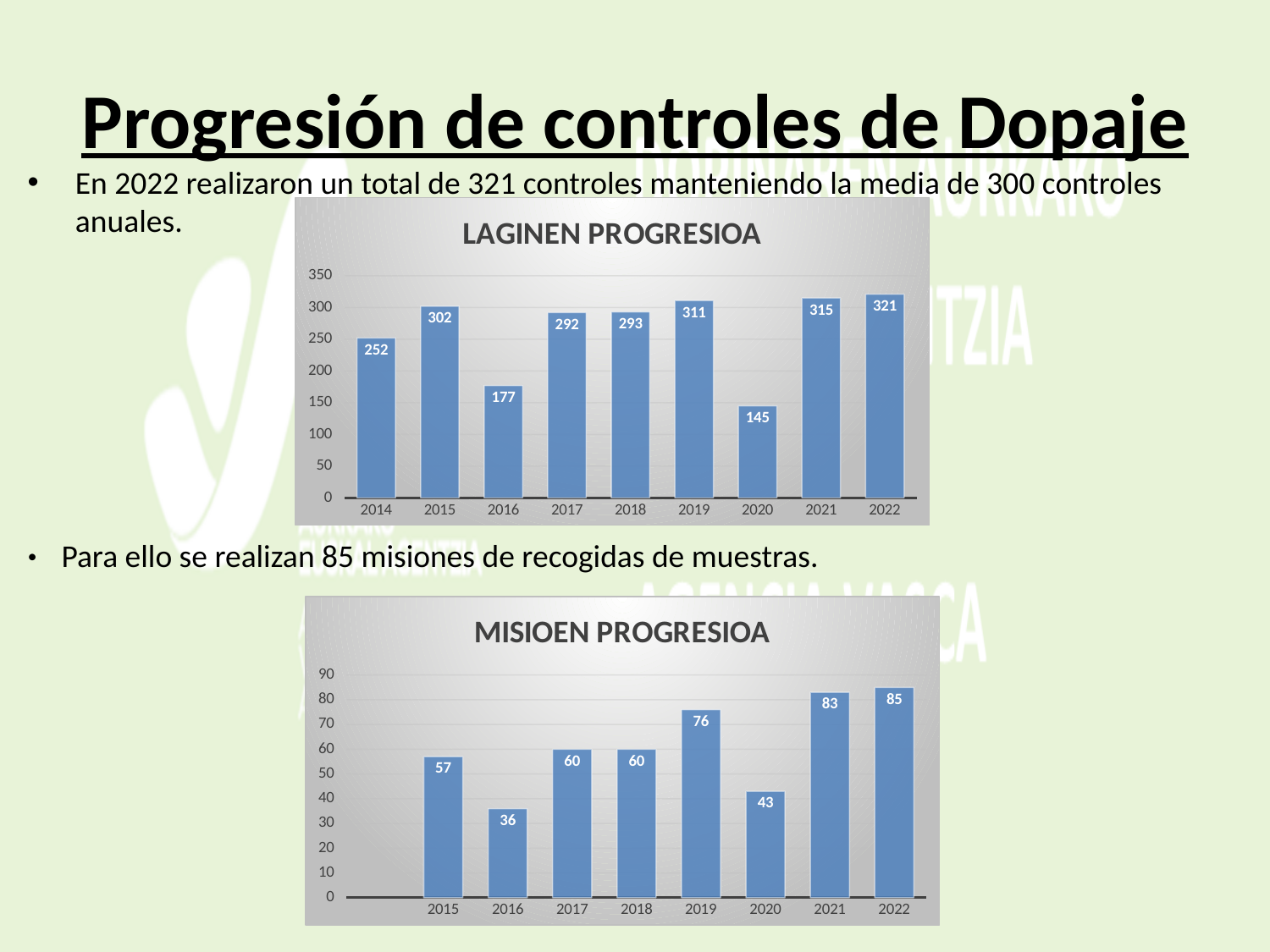
In the LAGINEN PROGRESIOA chart, how many years are shown on the x axis? 9 In the MISIOEN PROGRESIOA chart, which is larger, the value for 2015 or the value for 2020? 2015 In the LAGINEN PROGRESIOA chart, which year has the lowest value? 2020 In the LAGINEN PROGRESIOA chart, is the value for 2016 greater or less than 200? less In the MISIOEN PROGRESIOA chart, which year has the lowest value? 2016 In the MISIOEN PROGRESIOA chart, what is the difference between the values for 2021 and 2016? 47 In the LAGINEN PROGRESIOA chart, what is the difference between the values for 2022 and 2020? 176 What kind of chart is the MISIOEN PROGRESIOA chart? Bar chart In the LAGINEN PROGRESIOA chart, which year has the highest value? 2022 In the LAGINEN PROGRESIOA chart, what is the value for 2014? 252 In the MISIOEN PROGRESIOA chart, what is the value for 2019? 76 In the MISIOEN PROGRESIOA chart, how many years are shown on the x axis? 8